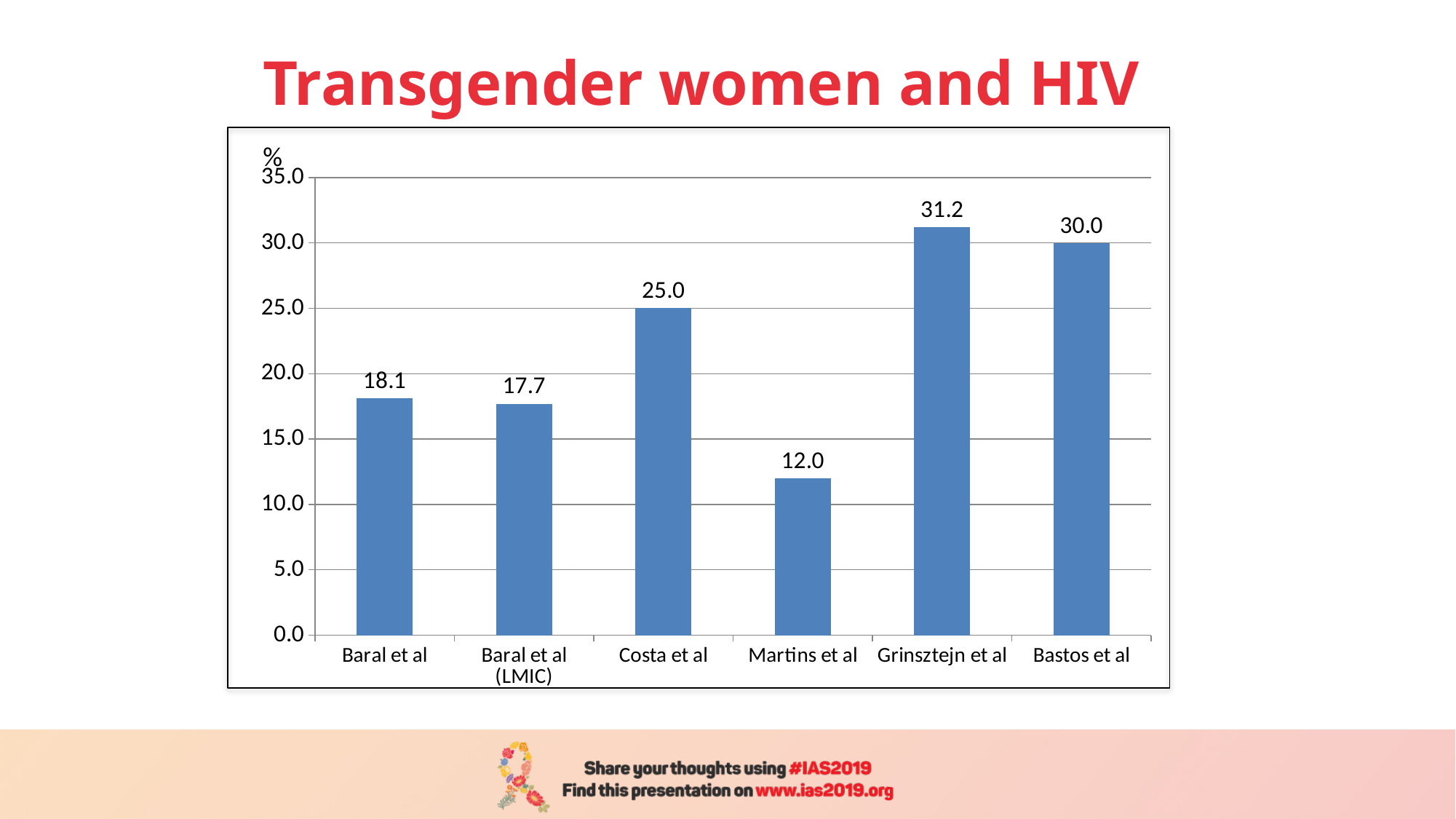
Is the value for Bastos et al greater or less than 25.0? greater Which is larger, the value for Baral et al or the value for Costa et al? Costa et al Which study has the highest value? Grinsztejn et al Which study has the lowest value? Martins et al What is the value for Costa et al? 25.0 How many studies are shown on the x axis? 6 What is the value for Martins et al? 12.0 What kind of chart is shown on the slide? bar chart What is the title of the slide? Transgender women and HIV What is the difference between the values for Grinsztejn et al and Bastos et al? 1.2 What is the value for Baral et al (LMIC)? 17.7 What is the difference between the values for Costa et al and Martins et al? 13.0